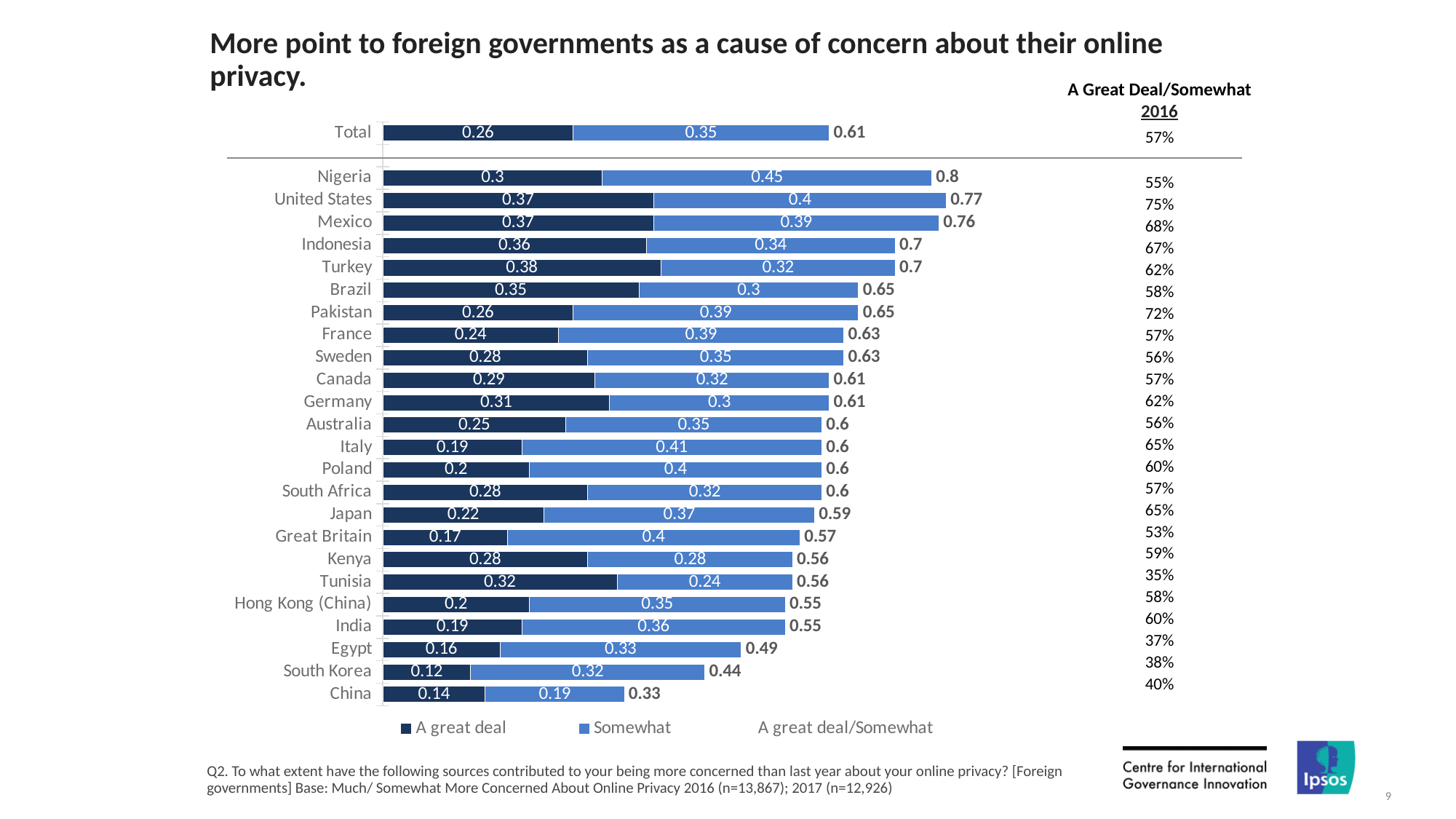
What is the 'A great deal' value for Nigeria? 0.3 What is the 'Somewhat' value for the Total bar? 0.35 What type of chart is shown on the slide? Stacked bar chart What is the 'Somewhat' value for Italy? 0.41 How many countries are shown in the chart, excluding the Total bar? 24 What is the difference between the combined totals for the United States and China? 0.44 Which country has the lowest combined 'A great deal/Somewhat' total? China What is the combined 'A great deal/Somewhat' total for Nigeria? 0.8 How many entries does the chart legend list? 3 Which has a larger 'A great deal' value, Turkey or France? Turkey Which country has the highest combined 'A great deal/Somewhat' total? Nigeria What is the 'A great deal' value for Egypt? 0.16